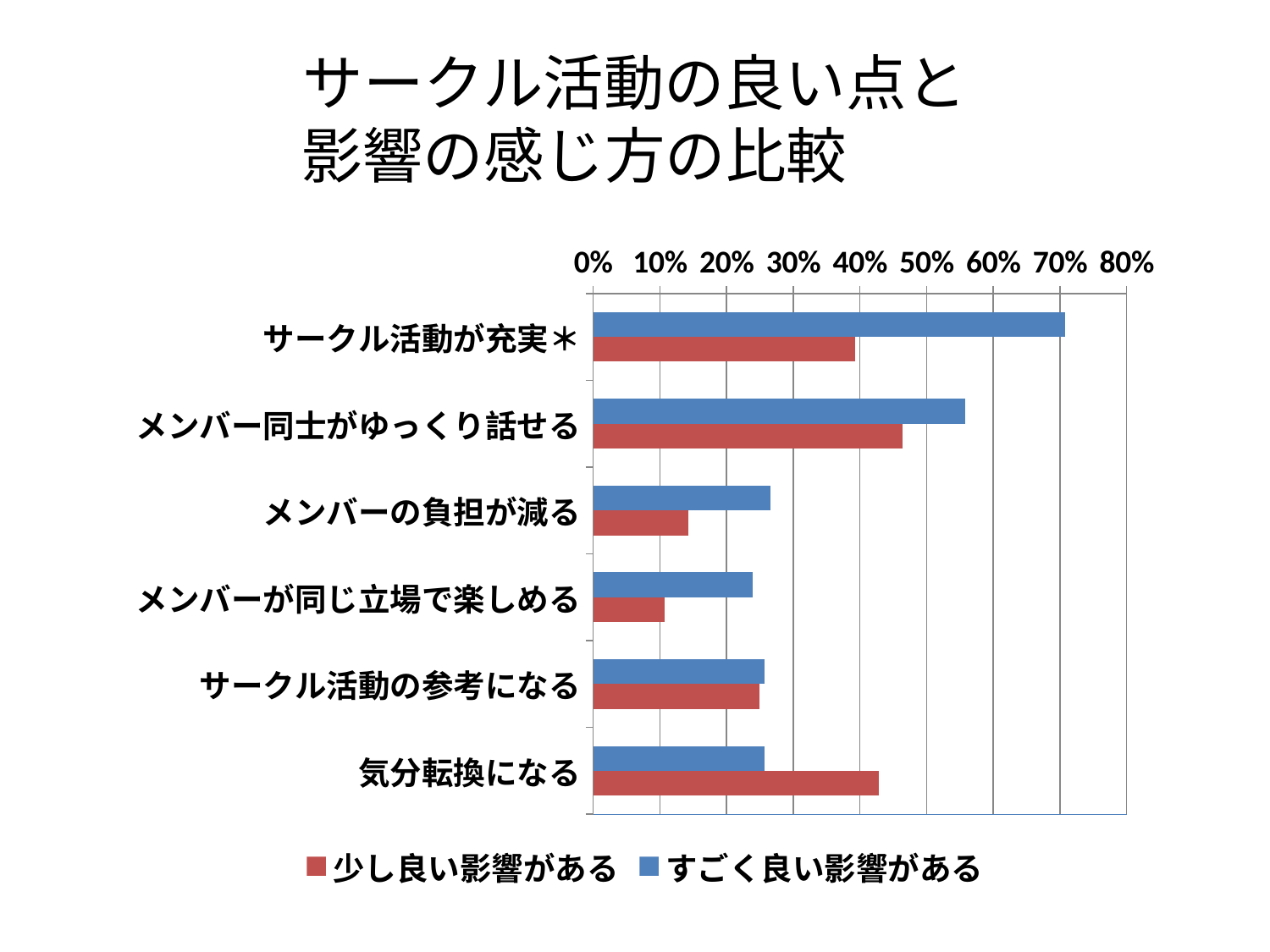
How many series does the legend list? 2 Which colour represents the すごく良い影響がある series? blue Which category has the lowest value for 少し良い影響がある? メンバーが同じ立場で楽しめる Is the value for メンバーの負担が減る in the 少し良い影響がある series greater or less than 20%? less Which category has the highest value for すごく良い影響がある? サークル活動が充実＊ For メンバーが同じ立場で楽しめる, which series has the larger value: 少し良い影響がある or すごく良い影響がある? すごく良い影響がある Is the value for メンバー同士がゆっくり話せる in the すごく良い影響がある series greater or less than 50%? greater How many categories are shown on the chart? 6 Is the value for 気分転換になる in the 少し良い影響がある series greater or less than 40%? greater For 気分転換になる, which series has the larger value: 少し良い影響がある or すごく良い影響がある? 少し良い影響がある What kind of chart is shown on the slide? bar chart